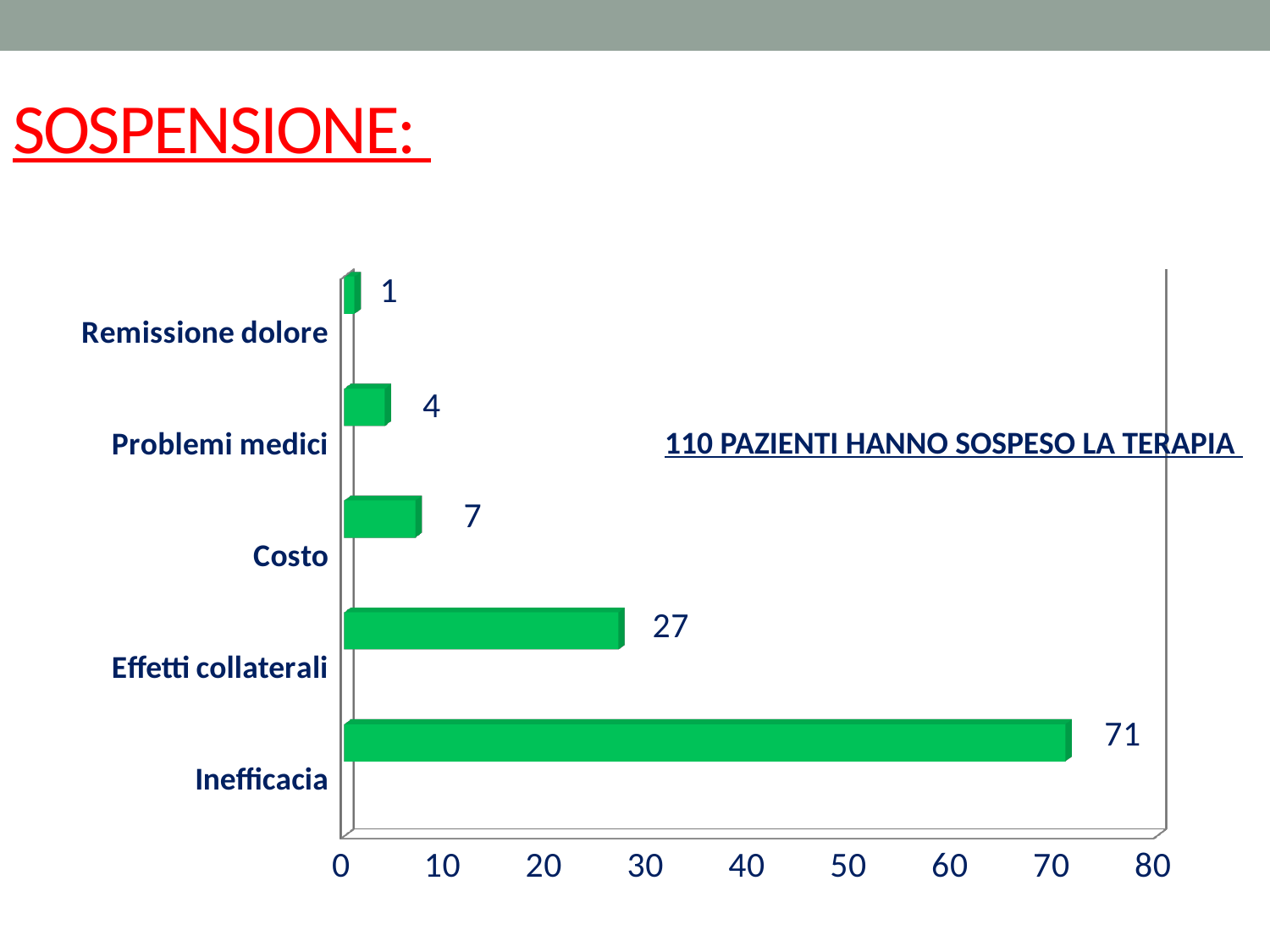
What is the total of all the values shown in the chart? 110 What kind of chart is shown on the slide? bar chart What is the value for Effetti collaterali? 27 Is the value for Effetti collaterali greater or less than 30? less Which category has the lowest value? Remissione dolore Which category has the highest value? Inefficacia What is the value for Inefficacia? 71 What is the difference between the values for Inefficacia and Effetti collaterali? 44 What is the value for Problemi medici? 4 How many categories are shown in the chart? 5 What is the value for Costo? 7 Which is larger, the value for Costo or the value for Problemi medici? Costo